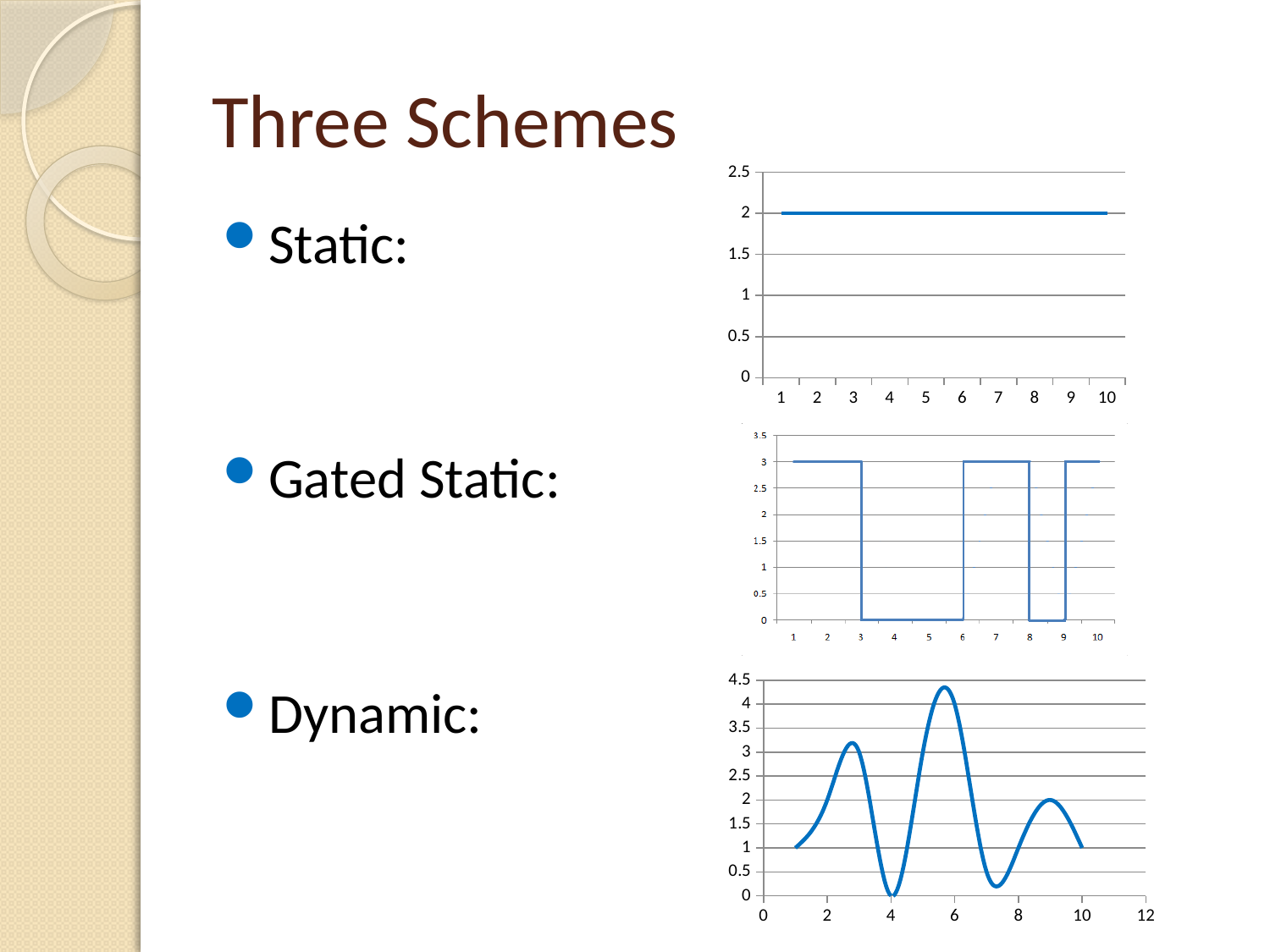
In the top (Static) chart, what value does the line hold across the x axis? 2 In the bottom (Dynamic) chart, which is larger: the peak near x = 3 or the peak near x = 9? the peak near x = 3 What kind of chart is the top chart next to 'Static'? line chart How many charts are shown on the slide? 3 In the top (Static) chart, does the value rise, fall, or stay flat along the x axis? stays flat In the middle (Gated Static) chart, what is the highest value the line reaches? 3 In the middle (Gated Static) chart, what is the value at x = 2? 3 In the middle (Gated Static) chart, is the value at x = 7 greater or less than 1? greater In the top (Static) chart, how many x-axis categories are labelled? 10 In the bottom (Dynamic) chart, is the peak near x = 6 greater or less than 4? greater In the bottom (Dynamic) chart, is the value at x = 4 greater or less than 0.5? less In the middle (Gated Static) chart, what is the value at x = 4? 0